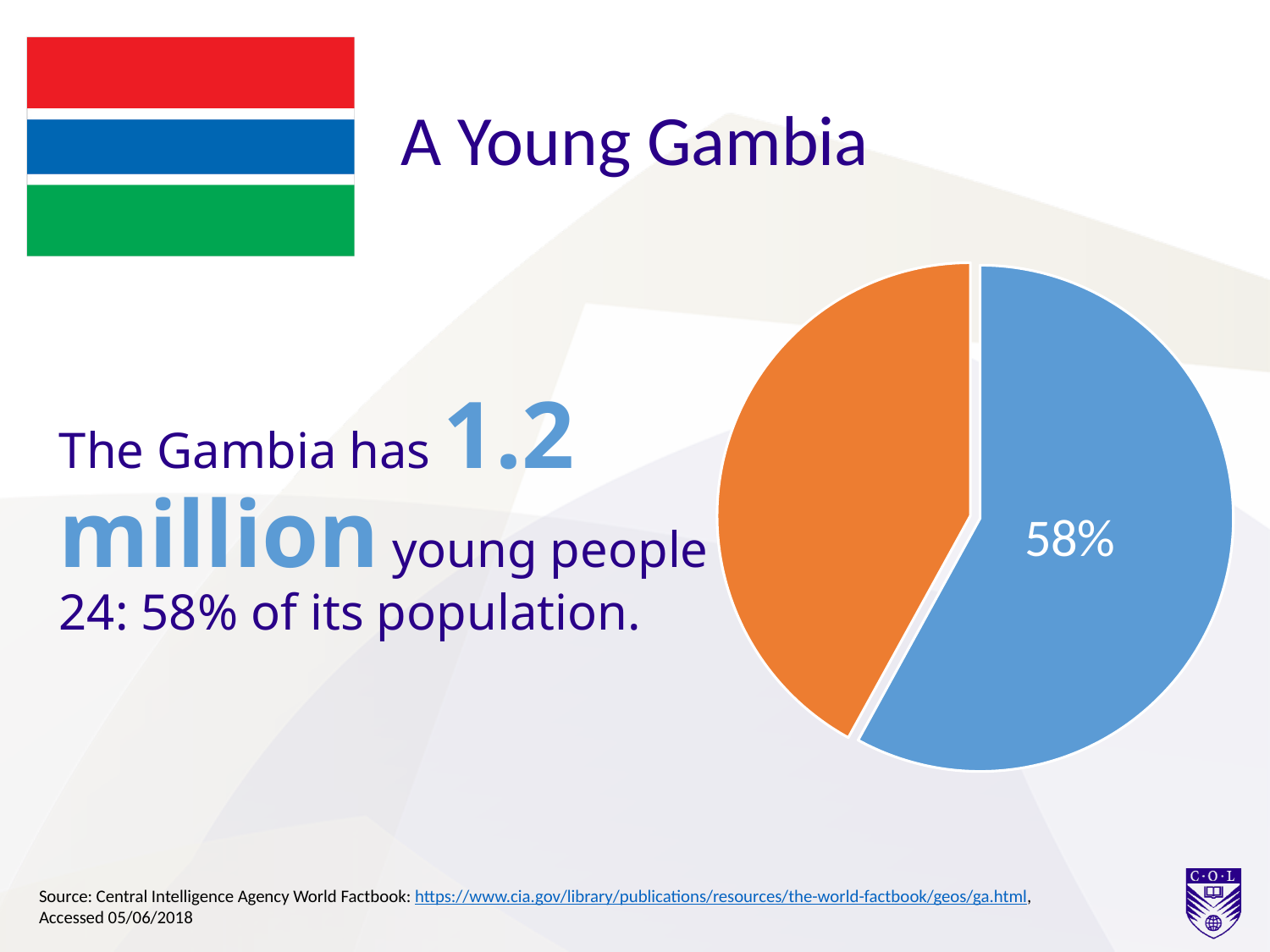
What is the title of the slide containing the pie chart? A Young Gambia According to the pie chart, what share of The Gambia's population is young people under 24? 58% Is the blue slice of the pie chart greater or less than half of the pie? greater What value is printed on the blue slice of the pie chart? 58% Is the orange slice of the pie chart greater or less than half of the pie? less What kind of chart is shown on the slide? pie chart Which slice of the pie chart is the smallest? the orange slice How many slices does the pie chart have? 2 Which slice of the pie chart is the largest? the blue slice Which is larger in the pie chart, the blue slice or the orange slice? the blue slice What two colours are used for the slices of the pie chart? blue and orange How many slices of the pie chart have a printed data label? 1